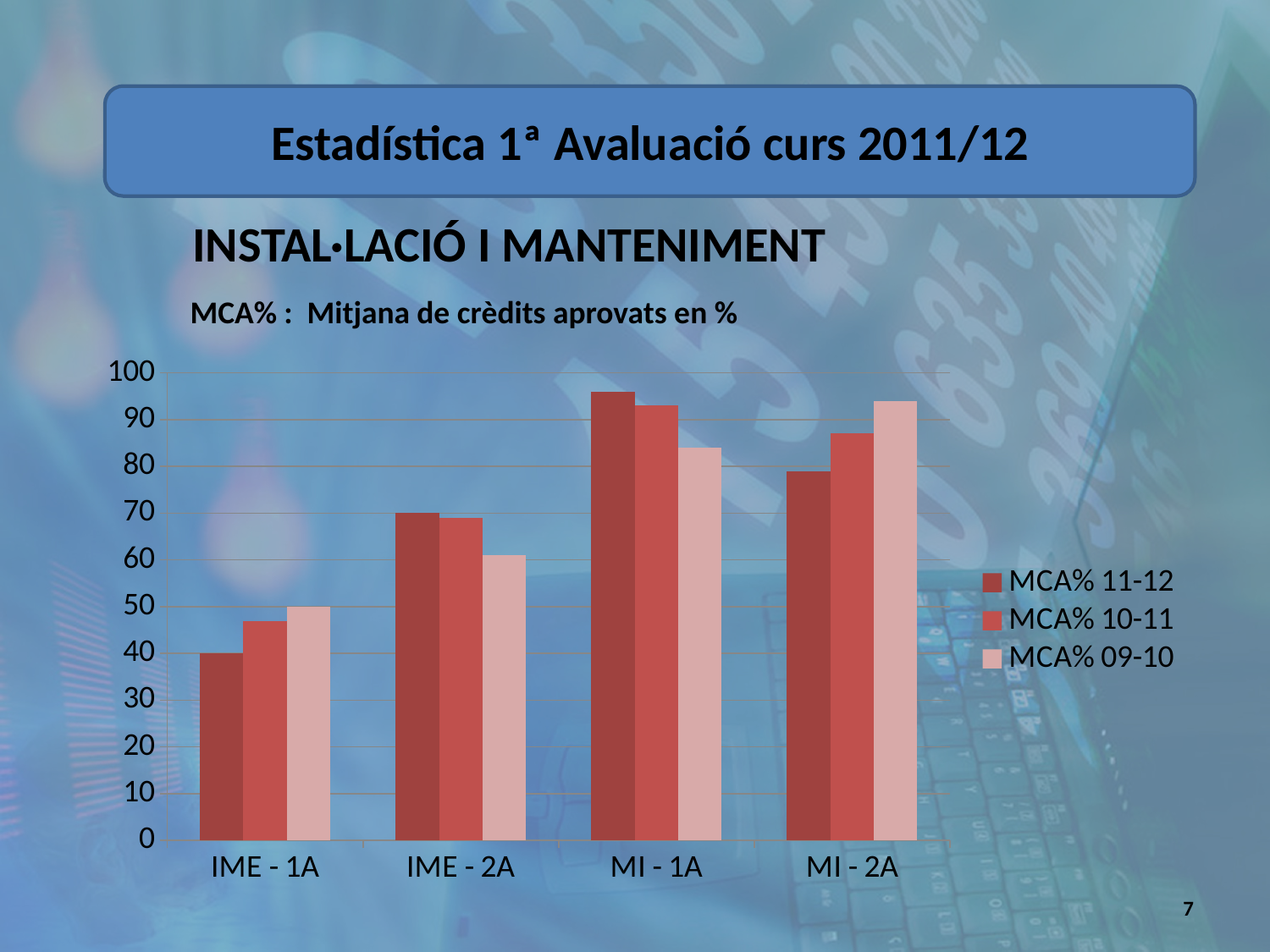
For MI - 2A, which is larger: the MCA% 09-10 value or the MCA% 11-12 value? MCA% 09-10 What is the MCA% 09-10 value for IME - 1A? 50 How many categories are shown on the x axis? 4 Is the MCA% 10-11 value for IME - 1A greater or less than 50? less What is the MCA% 11-12 value for IME - 2A? 70 Do the MCA% 09-10 values rise or fall from IME - 1A to MI - 2A? rise How many series does the legend list? 3 What is the MCA% 11-12 value for IME - 1A? 40 What kind of chart is shown on the slide? bar chart Which category has the highest MCA% 11-12 value? MI - 1A Is the MCA% 11-12 value for MI - 1A greater or less than 90? greater Which category has the lowest MCA% 11-12 value? IME - 1A